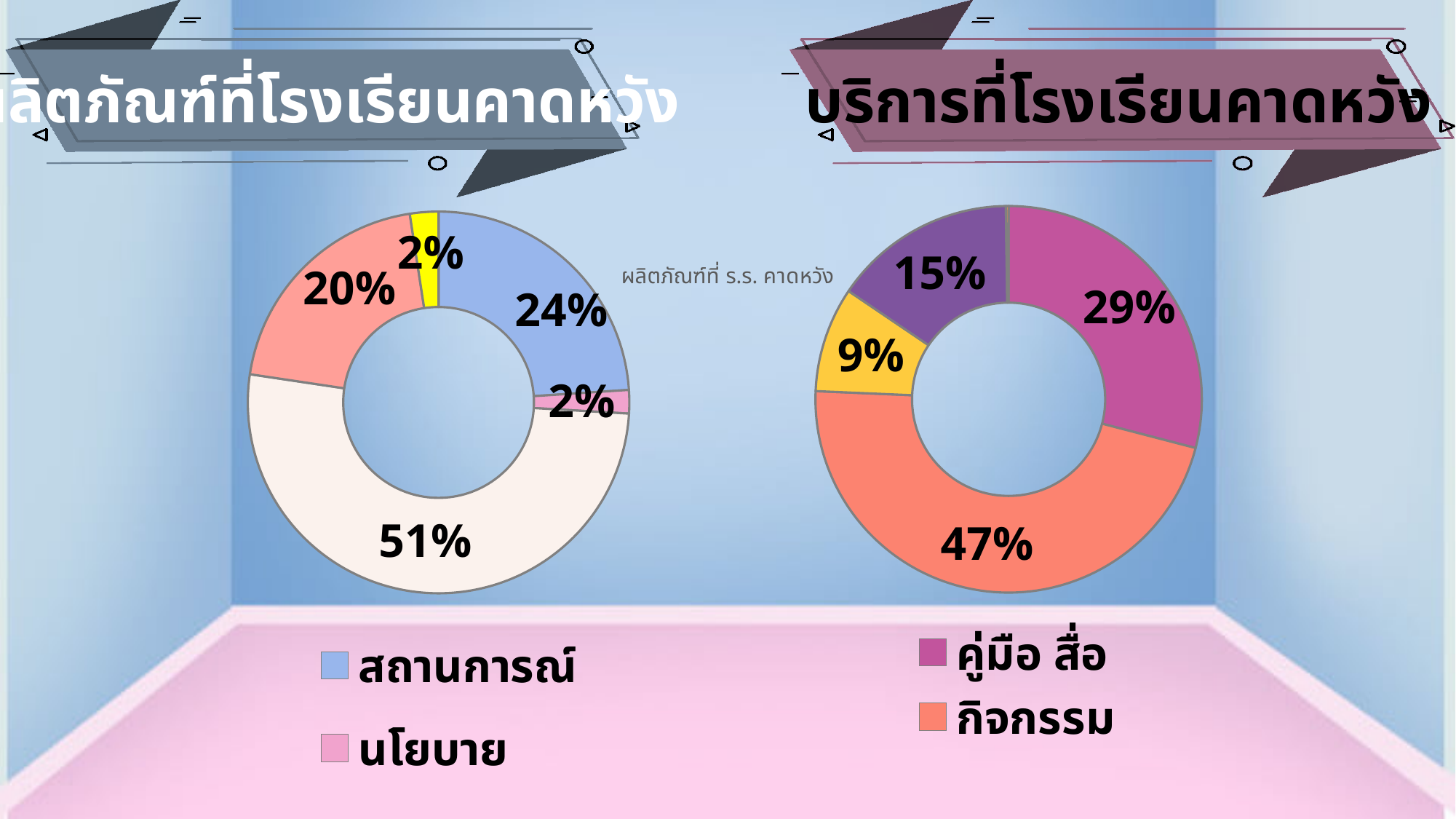
What type of chart is used on the right side of the slide (บริการที่โรงเรียนคาดหวัง)? Doughnut (pie) chart In the left chart (ผลิตภัณฑ์ที่โรงเรียนคาดหวัง), what percentage is shown for นโยบาย? 2% In the right chart (บริการที่โรงเรียนคาดหวัง), what is the smallest percentage shown on any slice? 9% In the left chart (ผลิตภัณฑ์ที่โรงเรียนคาดหวัง), which is larger, สถานการณ์ or นโยบาย? สถานการณ์ In the left chart (ผลิตภัณฑ์ที่โรงเรียนคาดหวัง), what percentage is shown for สถานการณ์? 24% In the left chart (ผลิตภัณฑ์ที่โรงเรียนคาดหวัง), what is the largest percentage shown on any slice? 51% In the right chart (บริการที่โรงเรียนคาดหวัง), what percentage is shown for คู่มือ สื่อ? 29% In the left chart (ผลิตภัณฑ์ที่โรงเรียนคาดหวัง), what is the difference between the สถานการณ์ slice and the นโยบาย slice? 22% In the right chart (บริการที่โรงเรียนคาดหวัง), what is the difference between the กิจกรรม slice and the คู่มือ สื่อ slice? 18% In the right chart (บริการที่โรงเรียนคาดหวัง), what percentage is shown for กิจกรรม? 47% In the right chart (บริการที่โรงเรียนคาดหวัง), how many slices does the doughnut have? 4 In the left chart (ผลิตภัณฑ์ที่โรงเรียนคาดหวัง), how many slices does the doughnut have? 5